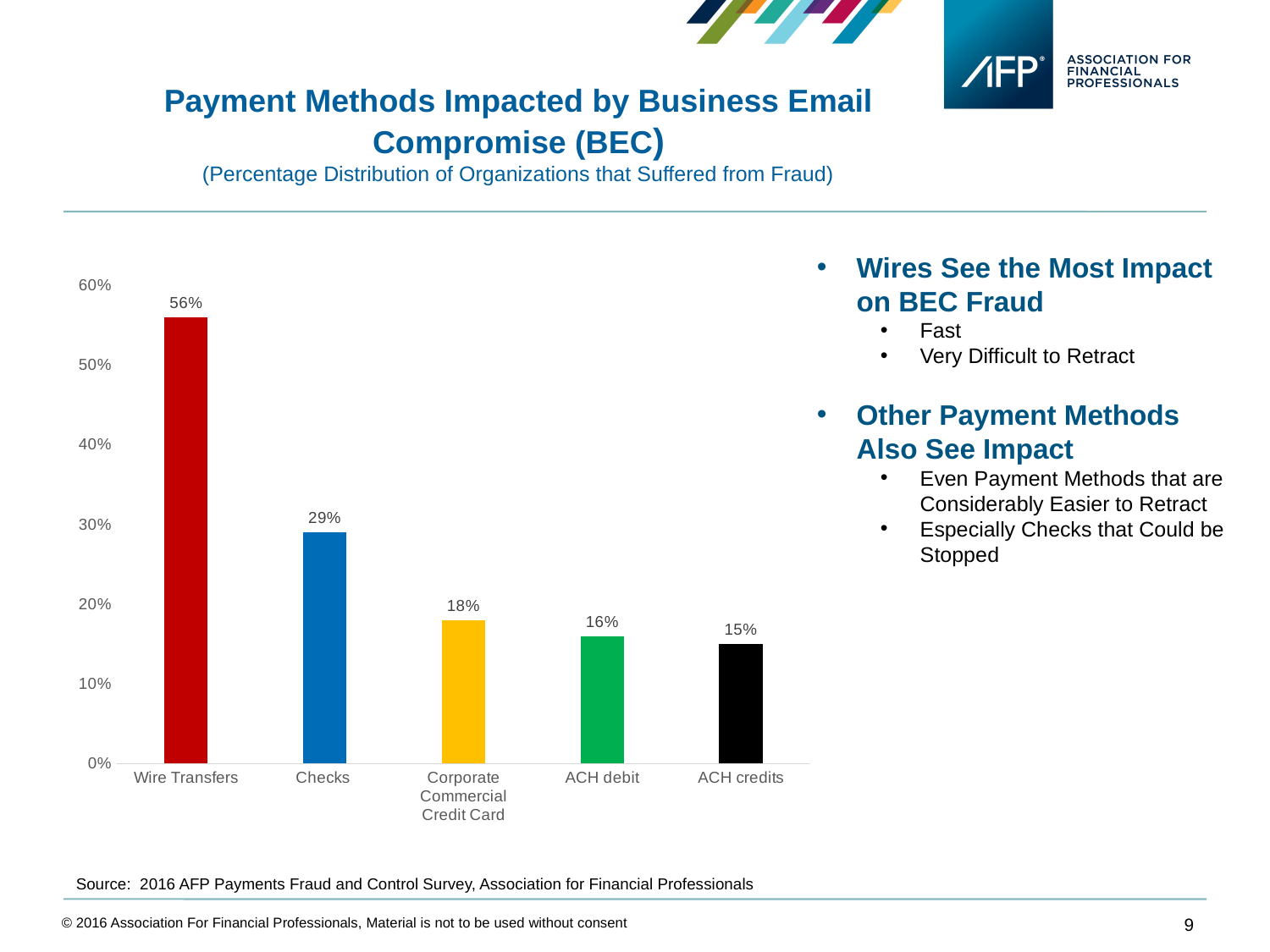
How many payment methods are shown in the chart? 5 Which payment method has the highest percentage? Wire Transfers What colour is the bar for Wire Transfers? red Which payment method has the lowest percentage? ACH credits What percentage is shown for Corporate Commercial Credit Card? 18% What percentage is shown for ACH credits? 15% What percentage is shown for Checks? 29% Is the value for Checks greater or less than 30%? less What percentage is shown for Wire Transfers? 56% Which is larger, the value for ACH debit or the value for Corporate Commercial Credit Card? Corporate Commercial Credit Card What kind of chart is shown on the slide? bar chart What is the difference in percentage points between Wire Transfers and Checks? 27